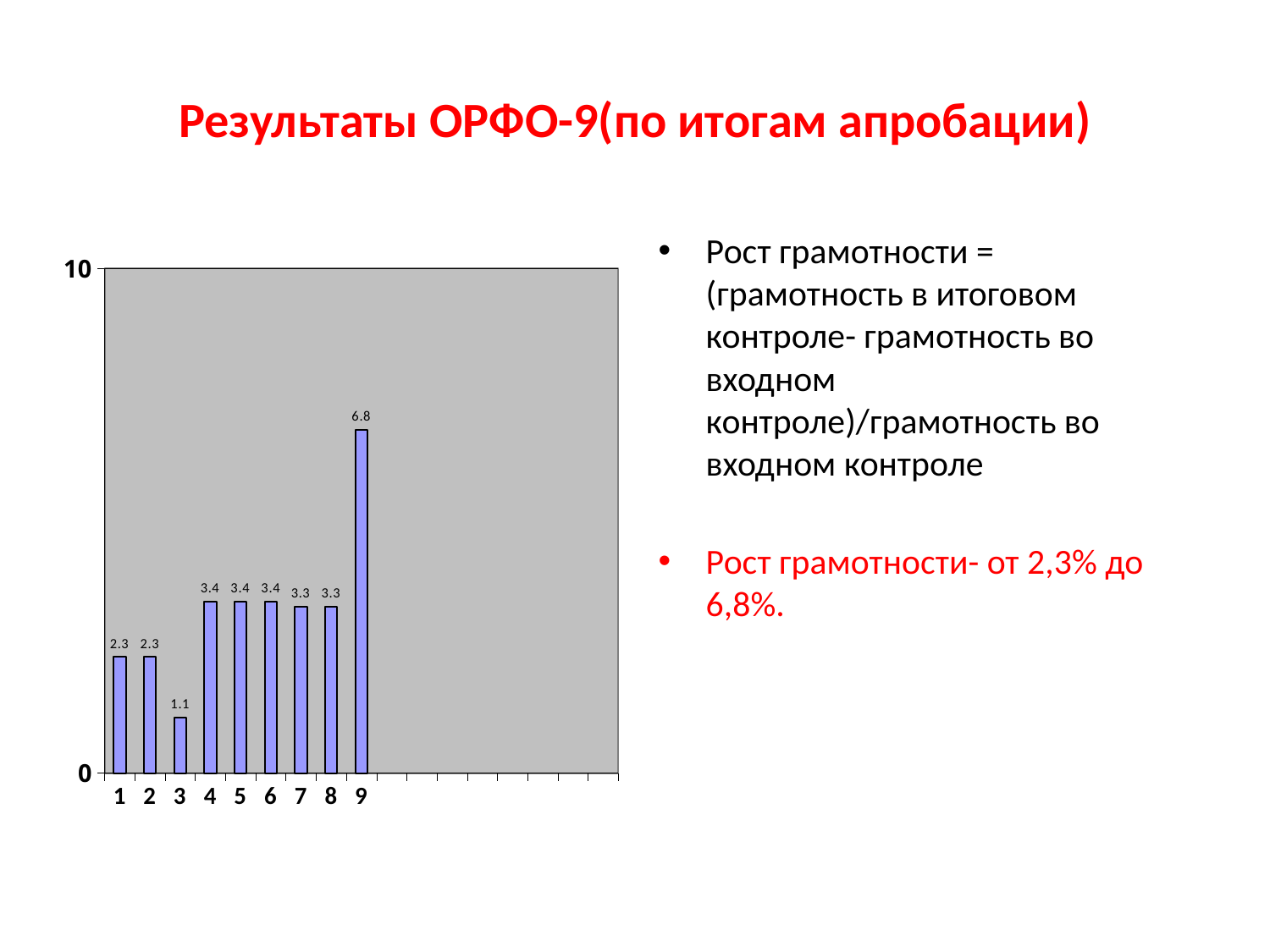
Which category has the highest value? 9 How many categories are plotted on the chart? 9 What is the maximum value shown on the vertical axis? 10 What is the value for category 9? 6.8 What is the value for category 7? 3.3 What is the difference between the values for category 9 and category 3? 5.7 What is the value for category 1? 2.3 What kind of chart is shown on the slide? bar chart Which category has the lowest value? 3 Which is larger, the value for category 5 or the value for category 2? category 5 What is the difference between the values for category 4 and category 1? 1.1 What is the value for category 3? 1.1